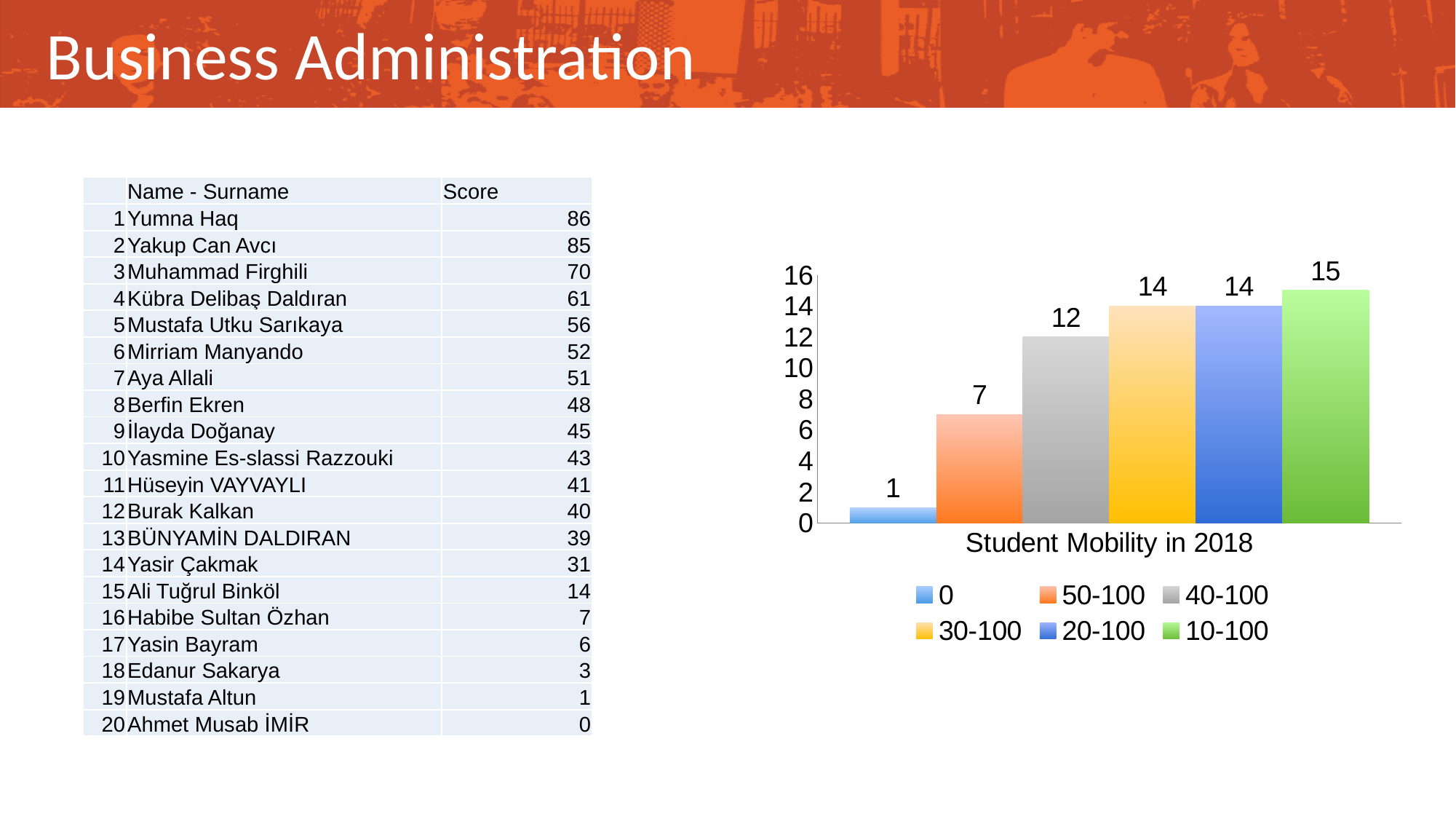
What is the value for the 40-100 series in the chart? 12 Which series has the lowest value in the chart? 0 What kind of chart is shown on the slide? bar chart What is the value for the 10-100 series in the chart? 15 Which is larger, the value for the 40-100 series or the value for the 50-100 series? 40-100 What is the value for the 0 series in the chart? 1 What is the value for the 50-100 series in the chart? 7 How many series does the chart legend list? 6 What is the difference between the values for the 10-100 series and the 50-100 series? 8 Which series has the highest value in the chart? 10-100 Is the value for the 30-100 series greater or less than 10? greater What is the category label shown below the bars in the chart? Student Mobility in 2018